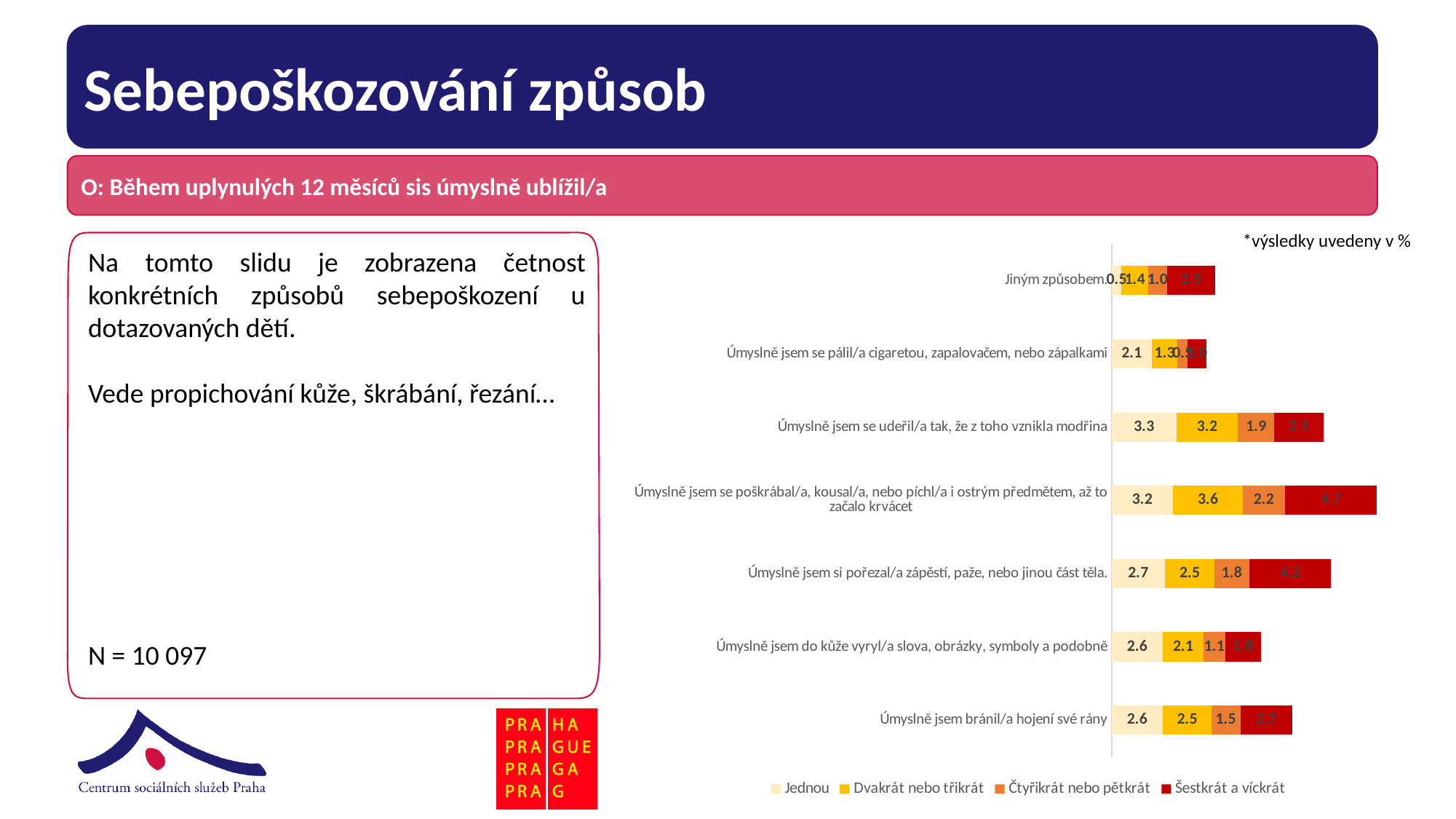
In what unit are the chart results given, according to the note above the chart? % What is the 'Jednou' value for 'Úmyslně jsem se udeřil/a tak, že z toho vznikla modřina'? 3.3 Which category has the longest total bar? Úmyslně jsem se poškrábal/a, kousal/a, nebo píchl/a i ostrým předmětem, až to začalo krvácet What kind of chart is shown on the slide? Stacked bar chart How many categories (self-harm methods) are plotted on the chart? 7 How many series does the chart legend list? 4 What is the total of the stacked bar for 'Úmyslně jsem si pořezal/a zápěstí, paže, nebo jinou část těla.'? 11.2 Which is larger: the 'Jednou' value for 'Úmyslně jsem se udeřil/a...' or the 'Jednou' value for 'Úmyslně jsem bránil/a hojení své rány'? Úmyslně jsem se udeřil/a... (3.3) What is the 'Dvakrát nebo třikrát' value for 'Úmyslně jsem si pořezal/a zápěstí, paže, nebo jinou část těla.'? 2.5 What is the 'Šestkrát a víckrát' value for 'Úmyslně jsem se poškrábal/a, kousal/a, nebo píchl/a i ostrým předmětem, až to začalo krvácet'? 4.7 What is the difference between the 'Šestkrát a víckrát' values for 'Úmyslně jsem se poškrábal/a...' (4.7) and 'Úmyslně jsem si pořezal/a...' (4.2)? 0.5 What is the 'Čtyřikrát nebo pětkrát' value for 'Úmyslně jsem do kůže vyryl/a slova, obrázky, symboly a podobně'? 1.1